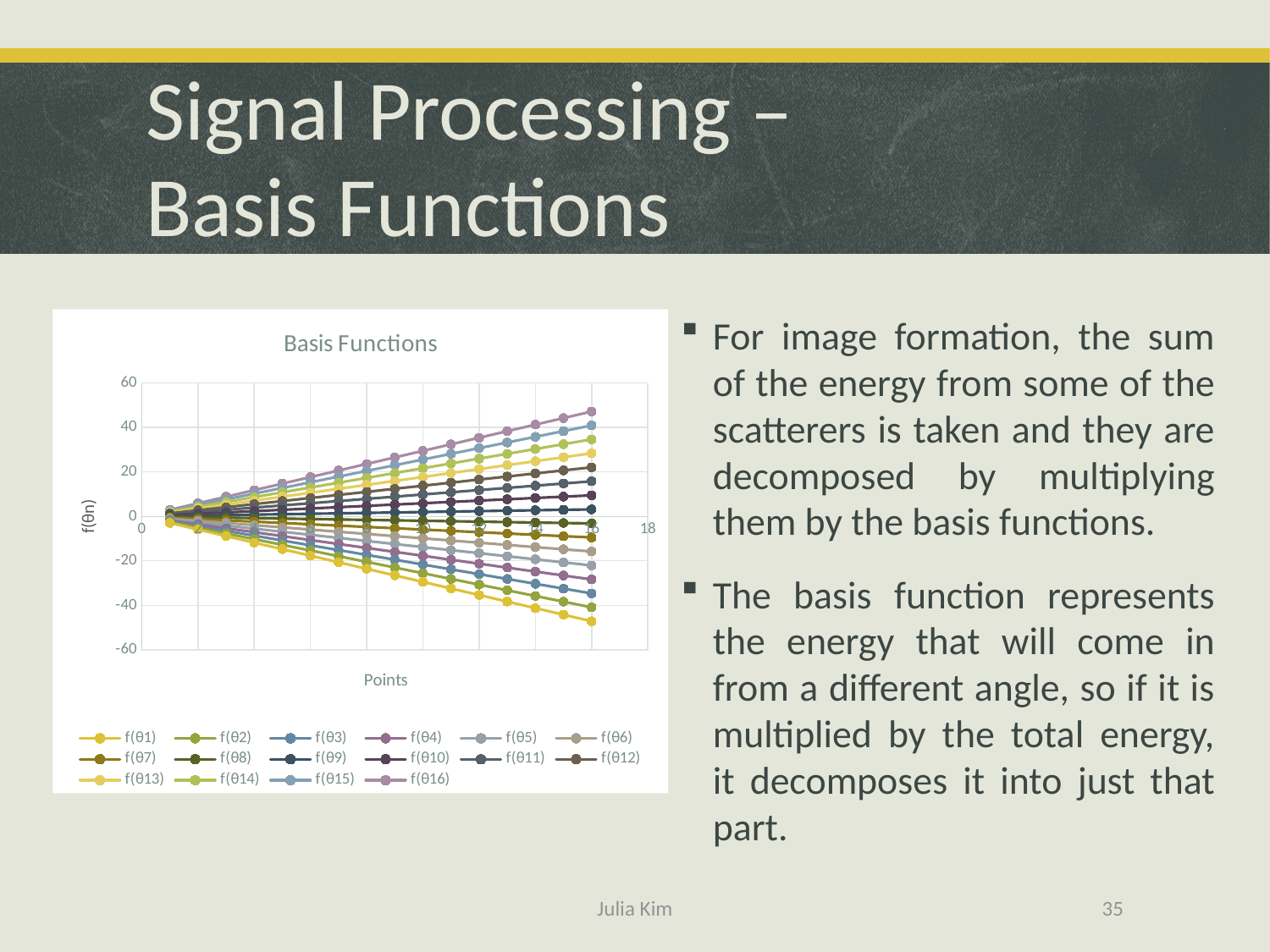
Do the values of the bottommost line rise or fall as the x axis increases? fall Is the highest value plotted on the chart greater or less than 40? greater How many series does the chart's legend list? 16 What kind of chart is shown on the slide? line chart What is the label of the x axis of the chart? Points What is the title of the chart? Basis Functions Is the highest value plotted on the chart greater or less than 60? less Is the lowest value plotted on the chart greater or less than -40? less Do the values of the topmost line rise or fall as the x axis increases? rise